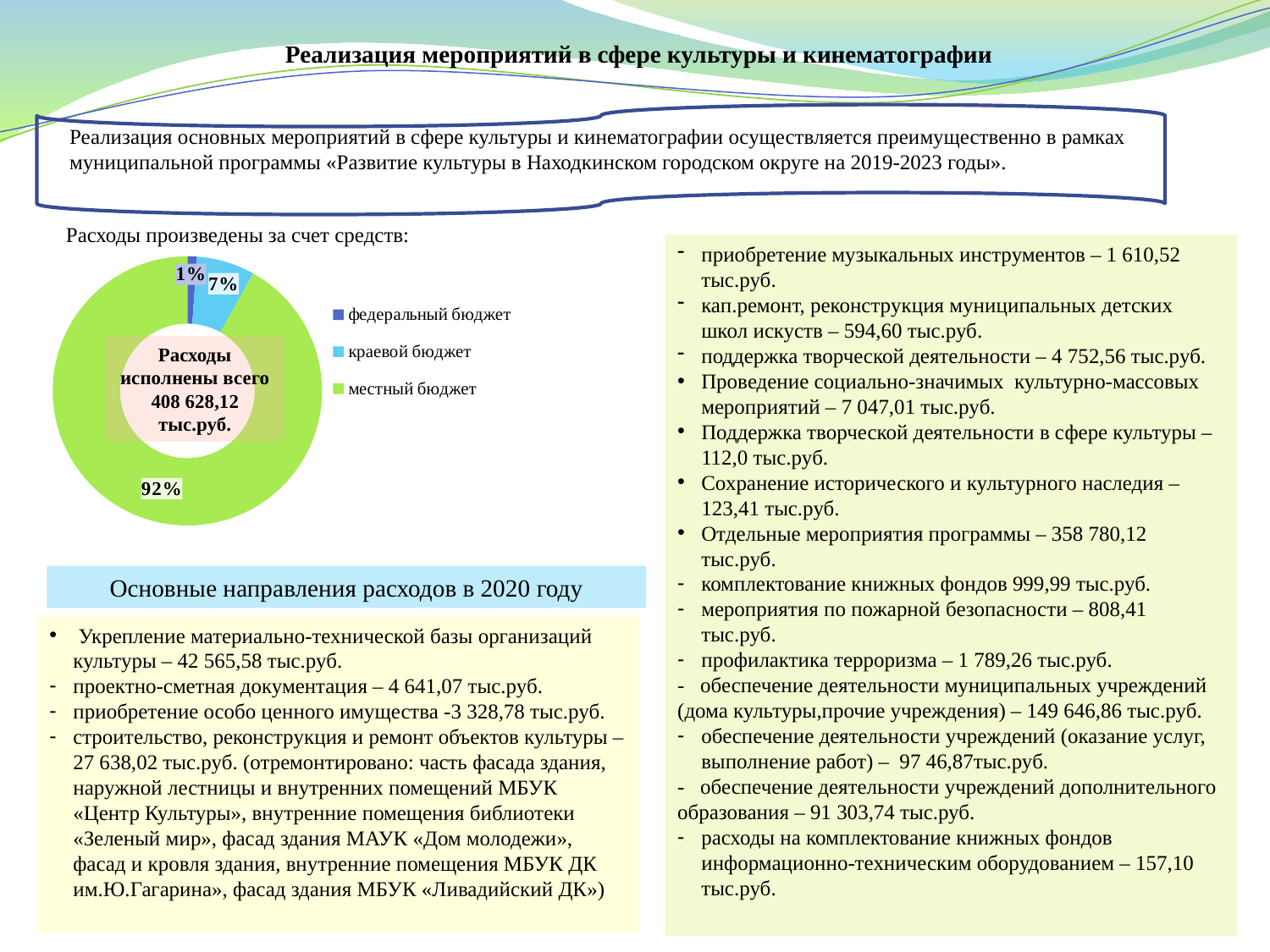
Which budget source has the smallest share in the pie chart? федеральный бюджет Which legend entry is shown in green in the pie chart? местный бюджет What total amount of expenditure is stated in the centre of the pie chart? 408 628,12 тыс.руб. How many categories does the pie chart's legend list? 3 What is the difference in percentage points between the share of местный бюджет and the share of краевой бюджет? 85 What share of the pie does федеральный бюджет account for? 1% Which budget source has the largest share in the pie chart? местный бюджет What share of the pie does краевой бюджет account for? 7% What share of the pie does местный бюджет account for? 92% Which is larger in the pie chart: the share of краевой бюджет or the share of федеральный бюджет? краевой бюджет What kind of chart is shown on the slide? pie chart